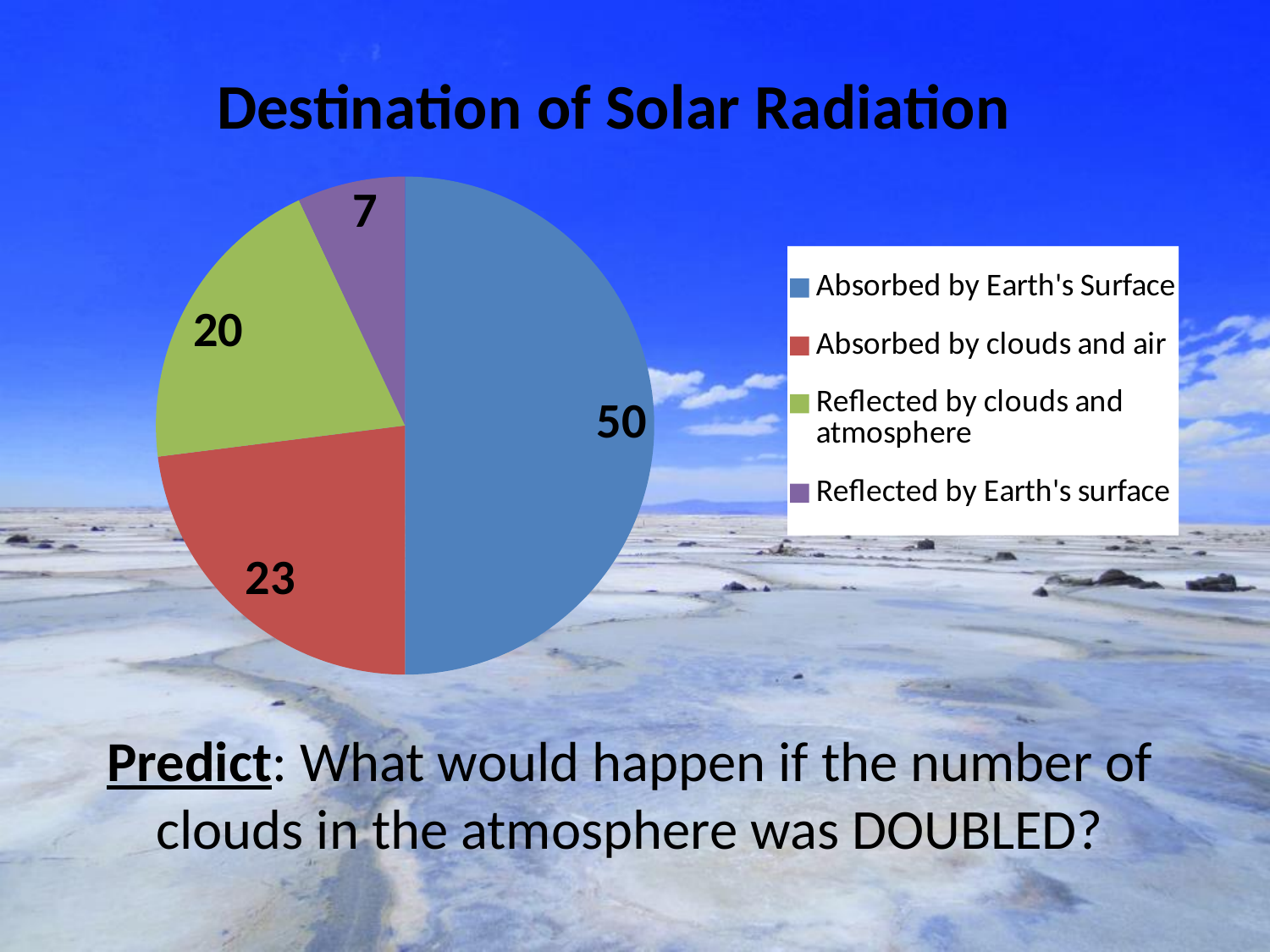
Which category has the smallest slice? Reflected by Earth's surface What type of chart is shown on the slide? pie chart What is the value for Absorbed by Earth's Surface? 50 Which is larger: Absorbed by clouds and air or Reflected by clouds and atmosphere? Absorbed by clouds and air Which category has the largest slice? Absorbed by Earth's Surface What is the value for Reflected by clouds and atmosphere? 20 How many categories does the pie chart have? 4 What share of the pie does Absorbed by Earth's Surface represent? 50% What is the value for Reflected by Earth's surface? 7 What is the value for Absorbed by clouds and air? 23 What is the difference between the values for Absorbed by Earth's Surface and Absorbed by clouds and air? 27 What is the title of the chart? Destination of Solar Radiation